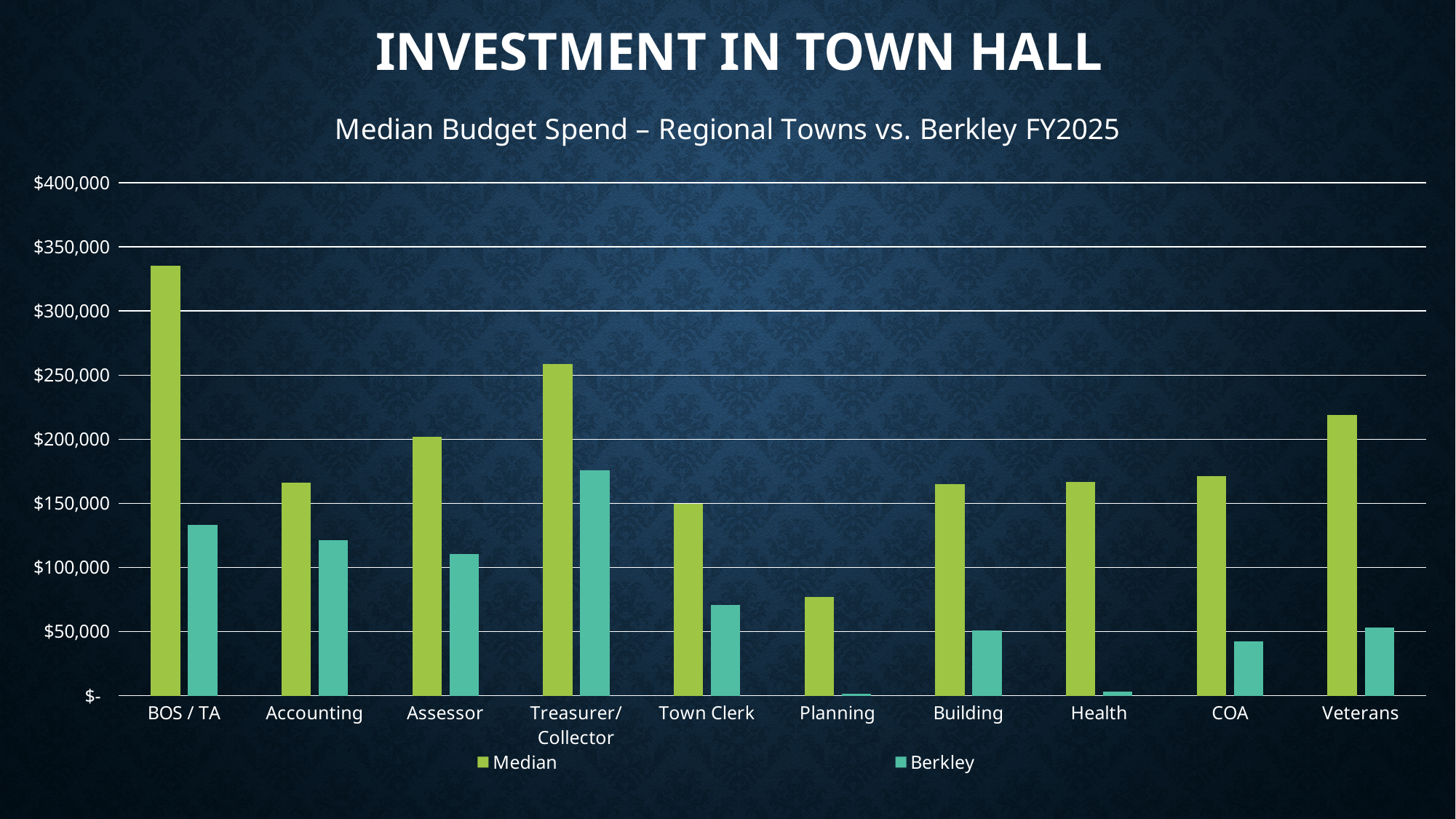
Which department has the highest Berkley value? Treasurer/ Collector Is the Berkley value for Treasurer/ Collector greater or less than $150,000? greater Which department has the highest Median value? BOS / TA Which department has the lowest Median value? Planning Is the Median value for BOS / TA greater or less than $300,000? greater For Accounting, which is larger, the Median value or the Berkley value? Median Is the Median value for Veterans greater or less than $200,000? greater How many departments are shown along the x axis? 10 What is the subtitle of the chart? Median Budget Spend – Regional Towns vs. Berkley FY2025 How many series does the legend list? 2 What kind of chart is shown on the slide? bar chart